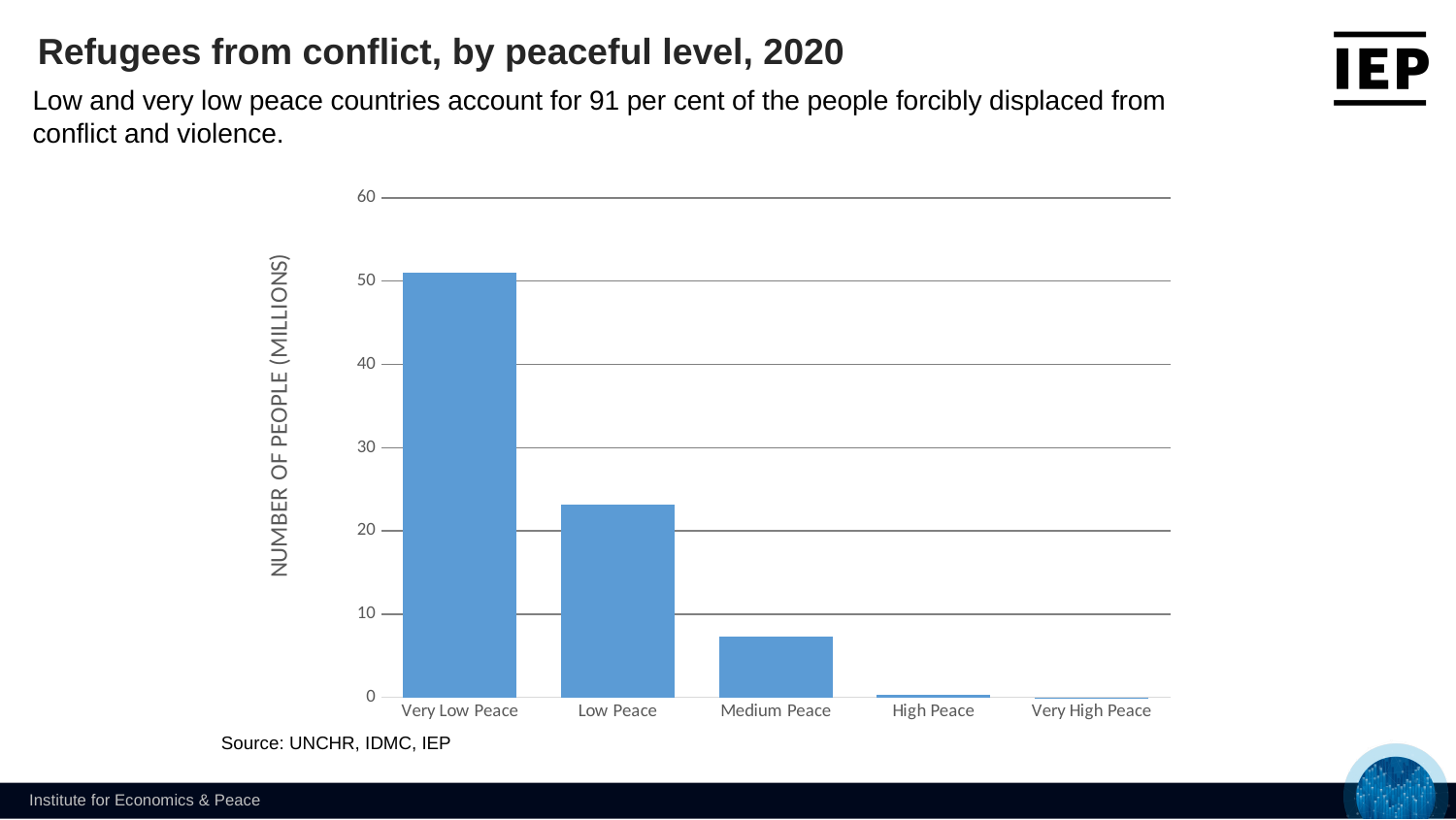
Which is larger, the value for Very Low Peace or the value for Low Peace? Very Low Peace How many peace-level categories are shown on the x axis? 5 What kind of chart is shown on the slide? bar chart Is the value for Low Peace greater or less than 30? less Which is larger, the value for Low Peace or the value for Medium Peace? Low Peace Do the values rise or fall moving from Very Low Peace to Very High Peace along the x axis? fall Is the value for Low Peace greater or less than 20? greater Is the value for Medium Peace greater or less than 10? less Which peace level has the highest number of people displaced? Very Low Peace What is the label of the y axis? NUMBER OF PEOPLE (MILLIONS)